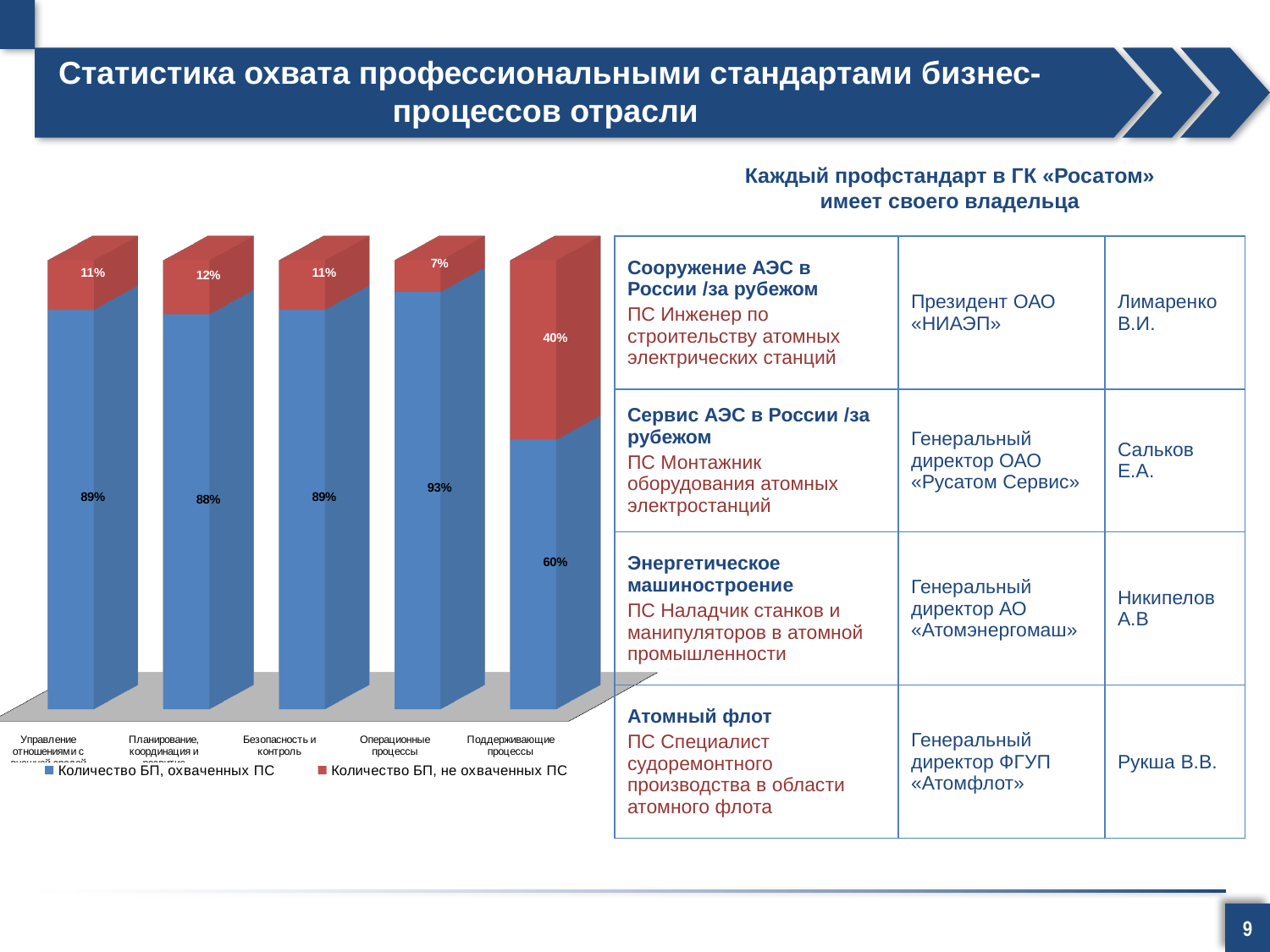
How many categories are shown on the chart? 5 Which category has the highest value for «Количество БП, не охваченных ПС»? Поддерживающие процессы What is the value of «Количество БП, не охваченных ПС» for «Операционные процессы»? 7% What is the value of «Количество БП, не охваченных ПС» for «Поддерживающие процессы»? 40% For «Операционные процессы», what is the difference between «Количество БП, охваченных ПС» and «Количество БП, не охваченных ПС»? 86% What kind of chart is shown on the slide? Stacked bar chart Which category has the lowest value for «Количество БП, охваченных ПС»? Поддерживающие процессы How many series does the chart legend list? 2 Which category has the highest value for «Количество БП, охваченных ПС»? Операционные процессы What is the value of «Количество БП, охваченных ПС» for «Операционные процессы»? 93% What is the value of «Количество БП, охваченных ПС» for «Безопасность и контроль»? 89% Which has the larger value for «Количество БП, охваченных ПС»: «Безопасность и контроль» or «Поддерживающие процессы»? Безопасность и контроль